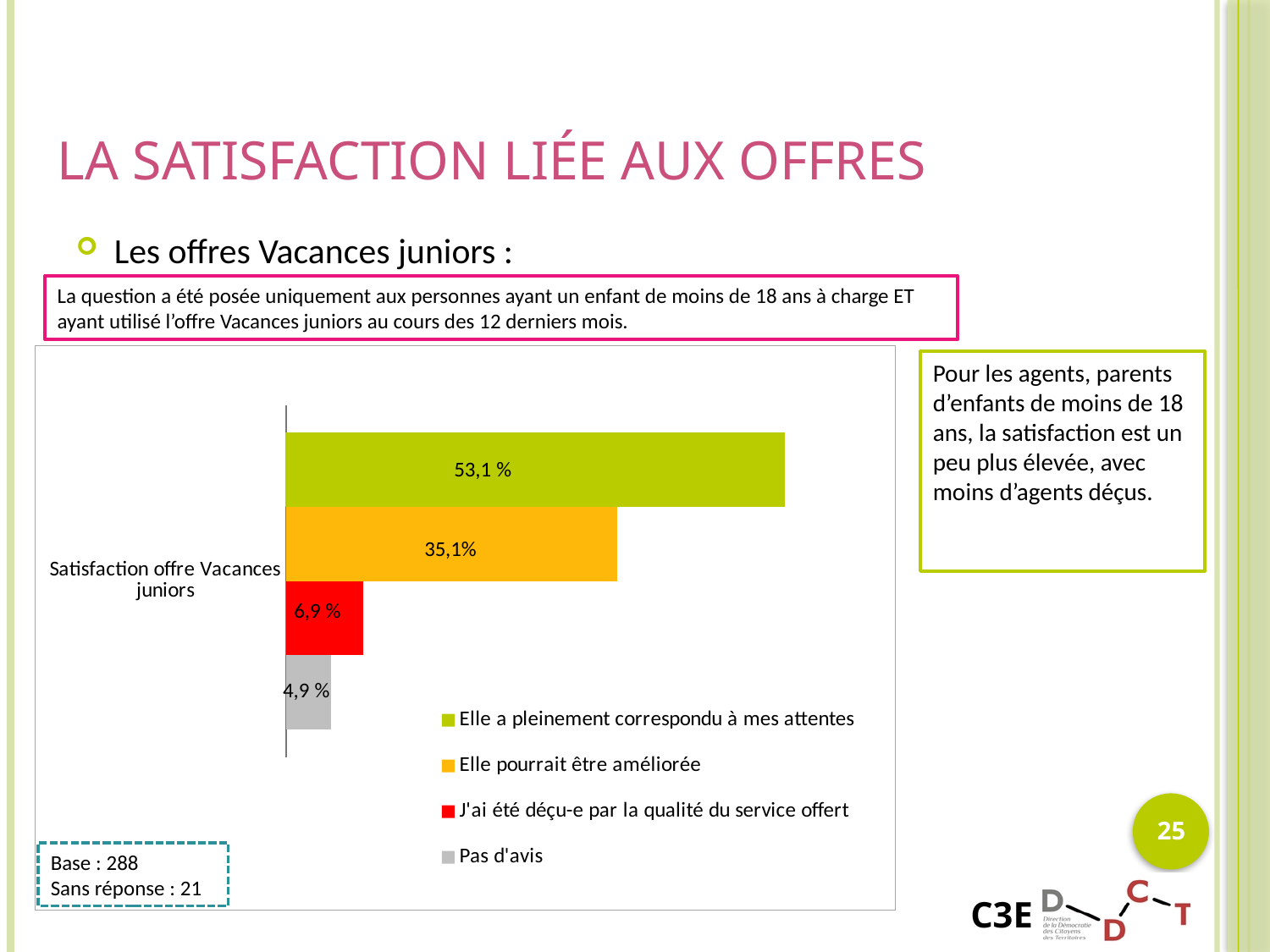
What is the difference between "J'ai été déçu-e par la qualité du service offert" and "Pas d'avis"? 2,0 % Which series has the lowest value? Pas d'avis What is the value for "Elle pourrait être améliorée"? 35,1% What is the value for "J'ai été déçu-e par la qualité du service offert"? 6,9 % What is the difference between "Elle a pleinement correspondu à mes attentes" and "Elle pourrait être améliorée"? 18,0 % What kind of chart is shown on the slide? Bar chart Which is larger: "Elle pourrait être améliorée" or "J'ai été déçu-e par la qualité du service offert"? Elle pourrait être améliorée Which series has the highest value? Elle a pleinement correspondu à mes attentes Which colour represents "Pas d'avis" in the chart? Grey What is the value for "Pas d'avis"? 4,9 % What is the value for "Elle a pleinement correspondu à mes attentes"? 53,1 % How many series does the legend list? 4